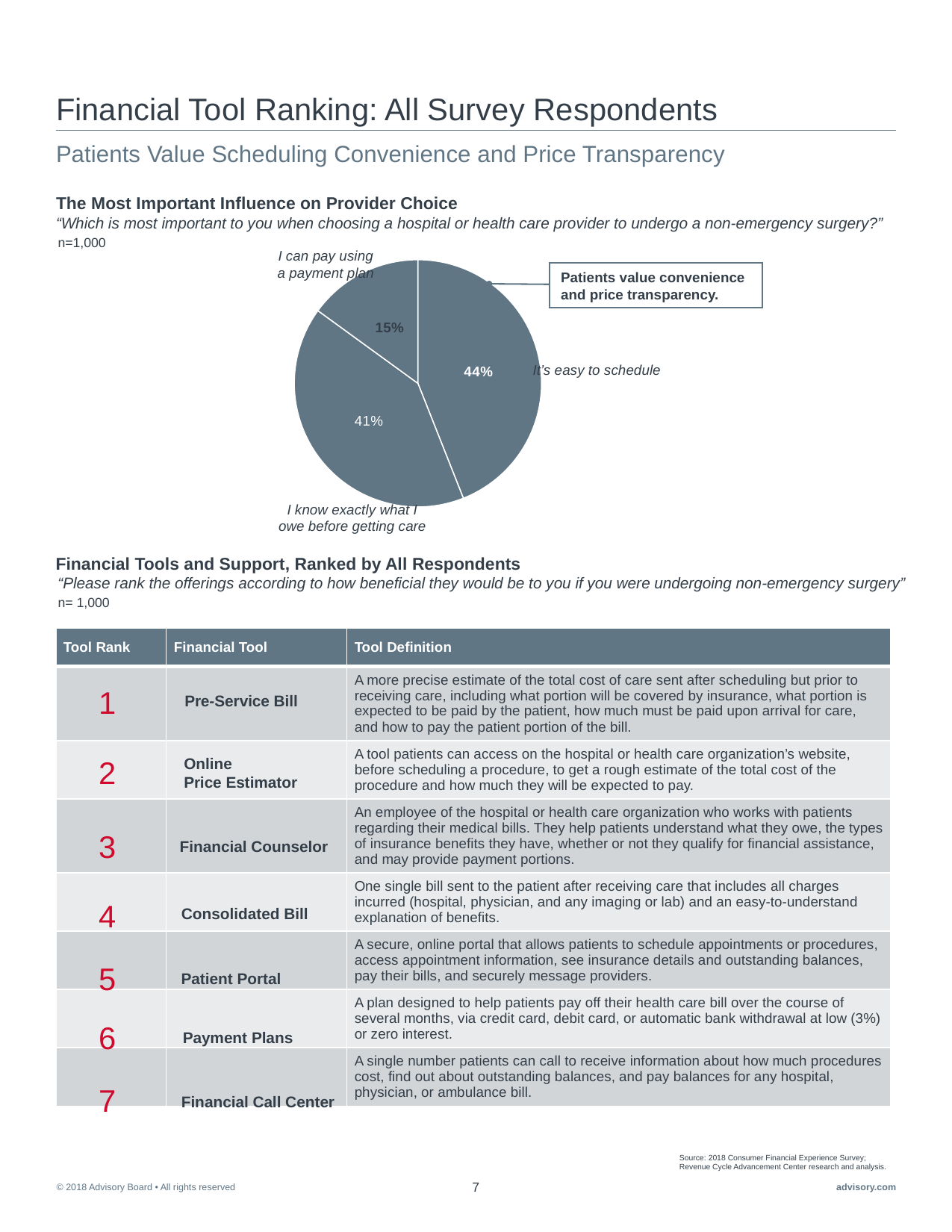
What share of respondents chose "I can pay using a payment plan"? 15% What share of respondents chose "It's easy to schedule" as the most important influence on provider choice? 44% How many slices does the pie chart have? 3 What does the callout box next to the pie chart say? Patients value convenience and price transparency. What kind of chart is shown under "The Most Important Influence on Provider Choice"? pie chart What is the sample size (n) stated for the pie chart? n=1,000 Which response has the smallest slice of the pie chart? I can pay using a payment plan What is the difference in percentage points between "I know exactly what I owe before getting care" and "I can pay using a payment plan"? 26 percentage points Which response has the largest slice of the pie chart? It's easy to schedule What is the difference in percentage points between "It's easy to schedule" and "I know exactly what I owe before getting care"? 3 percentage points Which is larger in the pie chart: "I know exactly what I owe before getting care" or "I can pay using a payment plan"? I know exactly what I owe before getting care What share of respondents chose "I know exactly what I owe before getting care"? 41%